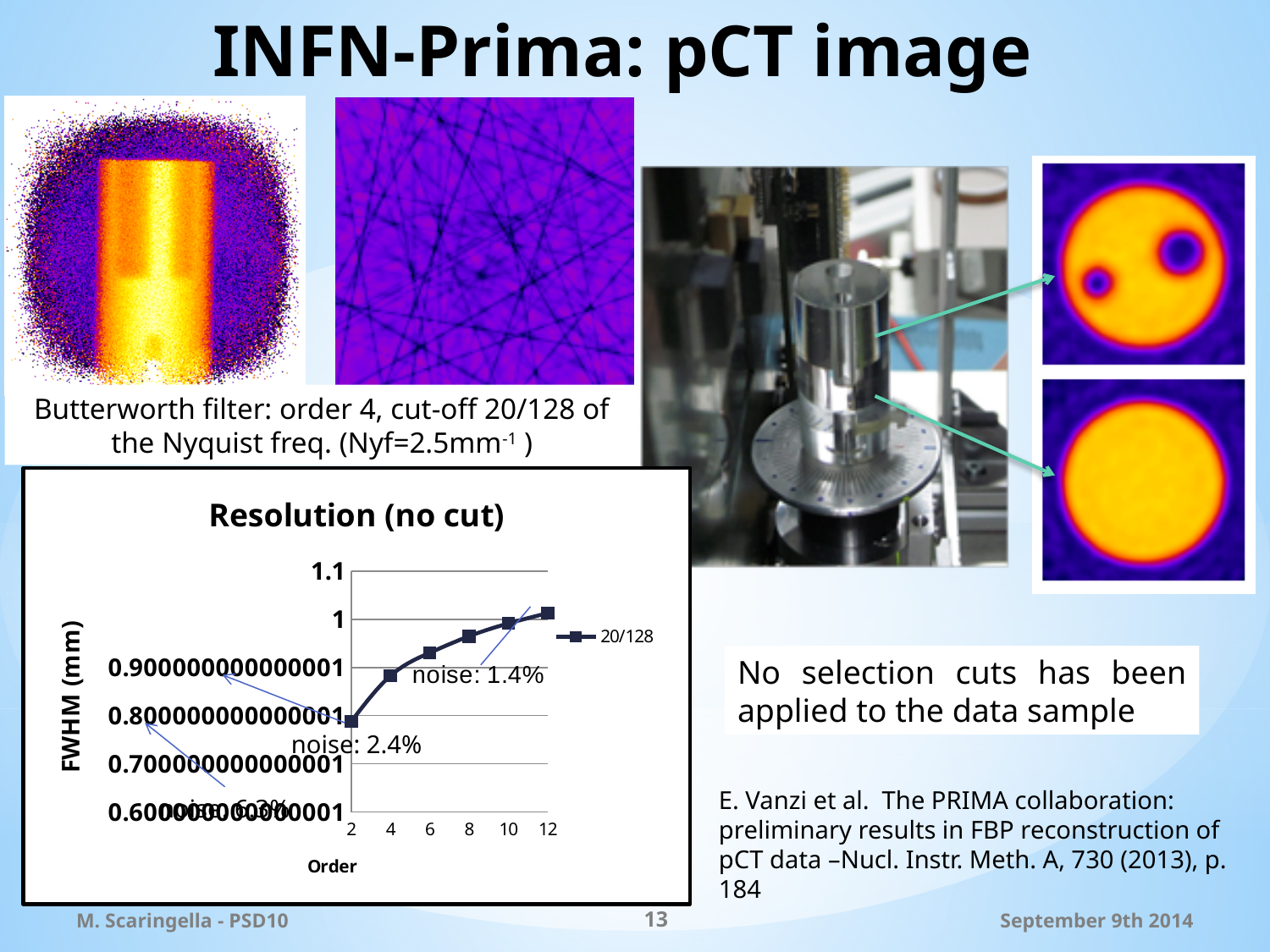
In the "Resolution (no cut)" chart, is the FWHM at Order 12 greater or less than 0.9? greater How many data points are plotted in the "Resolution (no cut)" chart? 6 What is the legend entry of the series in the "Resolution (no cut)" chart? 20/128 In the "Resolution (no cut)" chart, which has the larger FWHM: Order 2 or Order 12? Order 12 In the "Resolution (no cut)" chart, at which Order is the FWHM highest? 12 In the "Resolution (no cut)" chart, at which Order is the FWHM lowest? 2 In the "Resolution (no cut)" chart, is the FWHM at Order 10 greater or less than 1.1? less What is the title of the chart on the slide? Resolution (no cut) What kind of chart is "Resolution (no cut)"? line chart In the "Resolution (no cut)" chart, is the FWHM at Order 2 greater or less than 0.9? less How many series does the legend of the "Resolution (no cut)" chart list? 1 In the "Resolution (no cut)" chart, does FWHM rise or fall as Order increases? rise